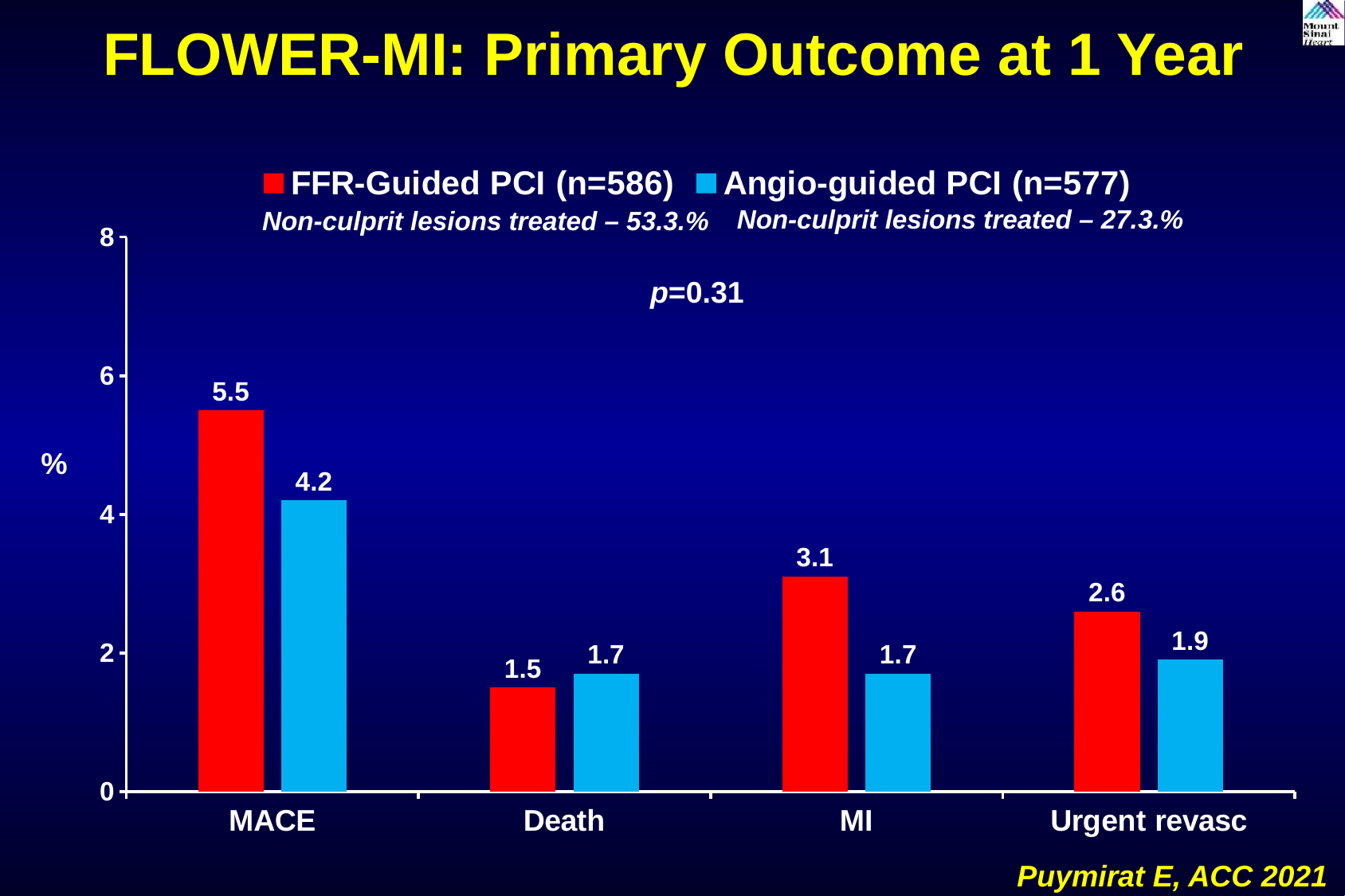
What is the Urgent revasc rate for FFR-Guided PCI? 2.6 What is the difference between the FFR-Guided PCI and Angio-guided PCI values for MI? 1.4 What is the MI rate for Angio-guided PCI? 1.7 Which outcome category has the lowest value for FFR-Guided PCI? Death What is the MACE rate for Angio-guided PCI? 4.2 What is the MACE rate for FFR-Guided PCI? 5.5 Which outcome category has the highest value for FFR-Guided PCI? MACE How many outcome categories are shown on the x axis? 4 What kind of chart is shown on the slide? Bar chart For Death, which group has the larger value, FFR-Guided PCI or Angio-guided PCI? Angio-guided PCI What p-value is shown on the chart? p=0.31 How many series does the legend list? 2